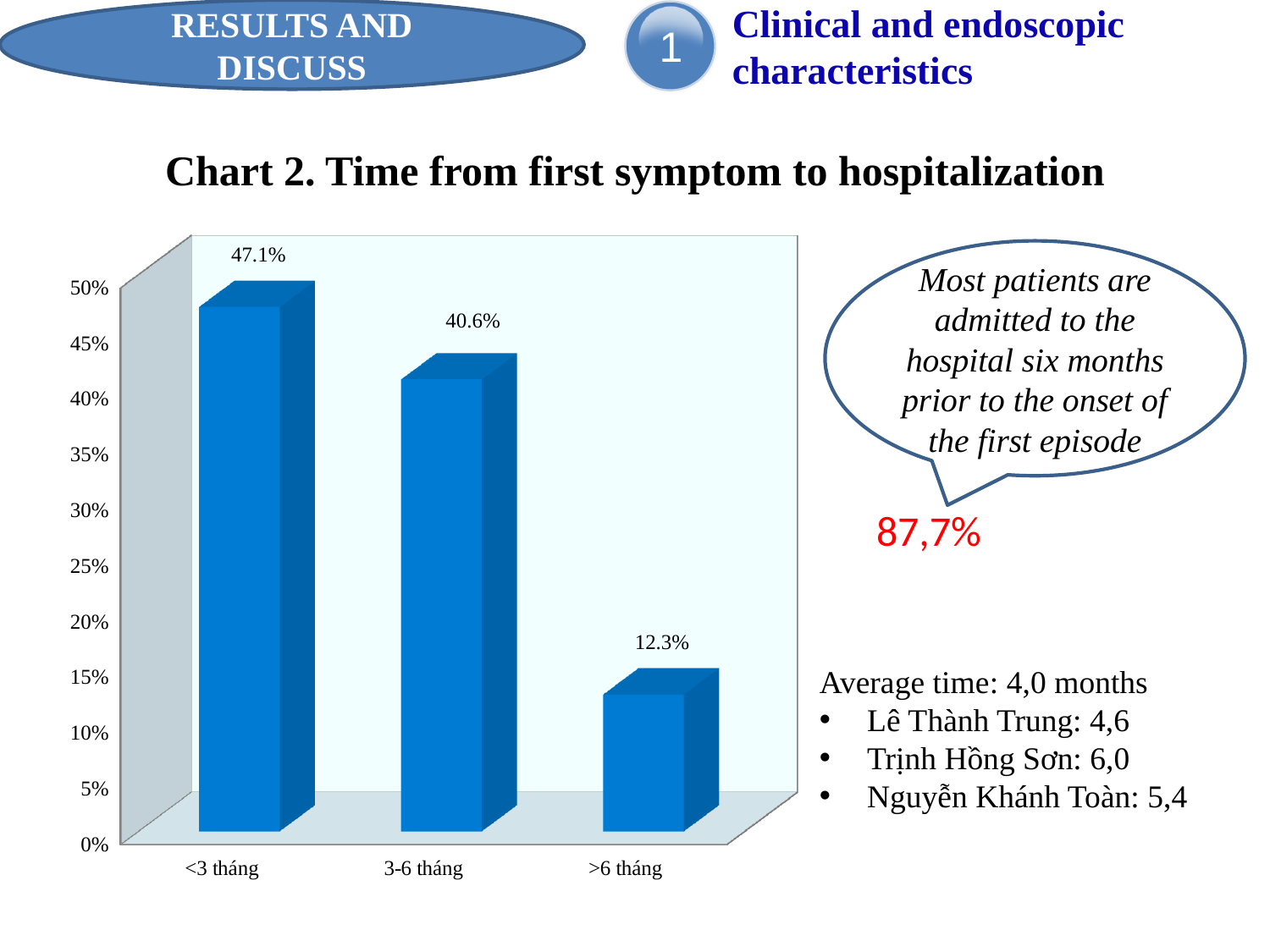
How many categories are shown on the x axis? 3 Is the value for ">6 tháng" greater or less than 15%? less Which category has the highest value? <3 tháng Which is larger, the value for "3-6 tháng" or the value for ">6 tháng"? 3-6 tháng What is the value for the "<3 tháng" category? 47.1% What is the difference between the values for "<3 tháng" and "3-6 tháng"? 6.5% Which category has the lowest value? >6 tháng What is the title of the chart? Chart 2. Time from first symptom to hospitalization What kind of chart is shown on the slide? bar chart What is the difference between the values for "3-6 tháng" and ">6 tháng"? 28.3% What is the value for the "3-6 tháng" category? 40.6% What is the value for the ">6 tháng" category? 12.3%